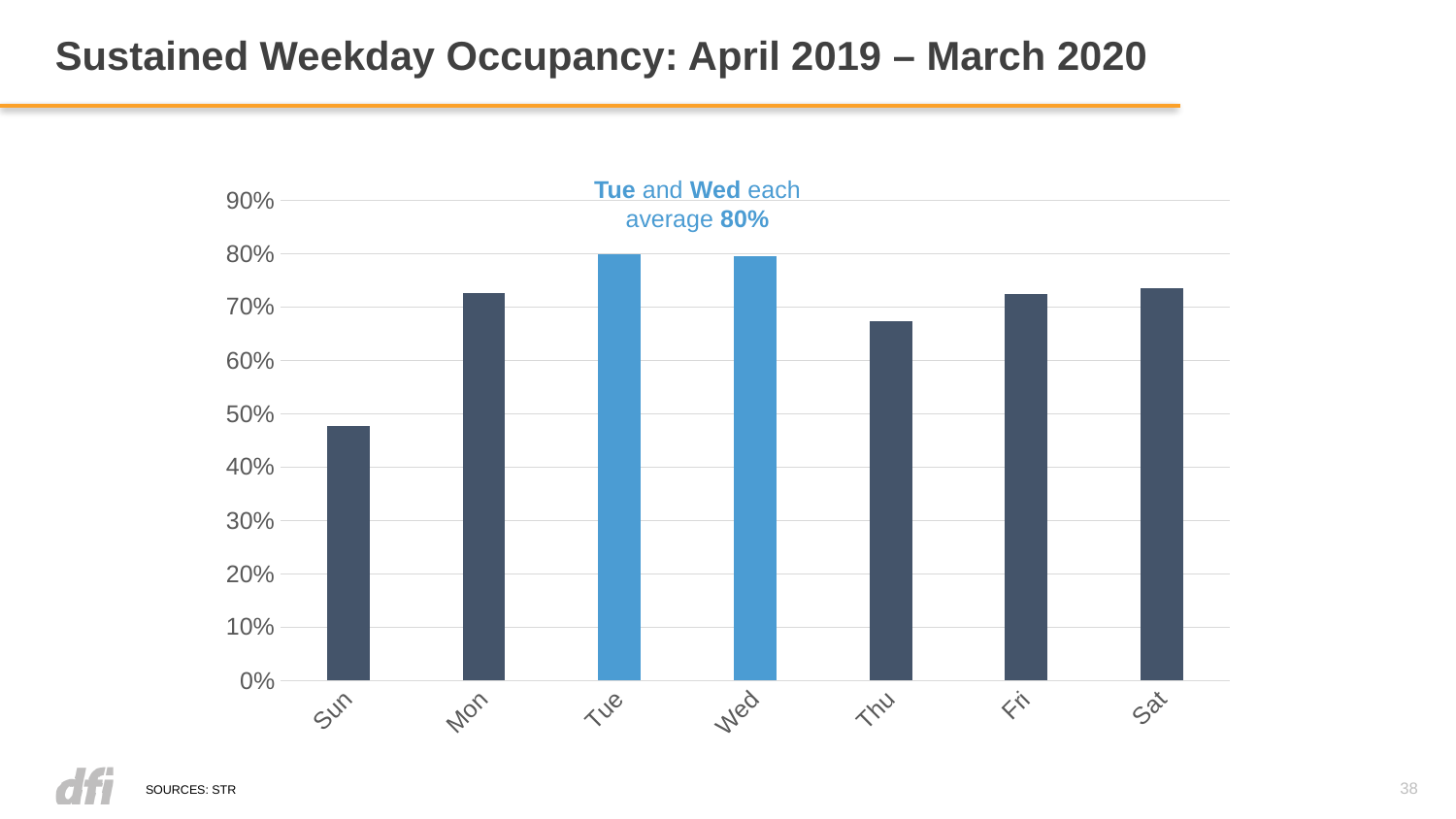
How many days of the week are plotted on the chart? 7 Is the value for Mon greater or less than 70%? greater According to the annotation on the chart, what is the average occupancy for Wed? 80% Which two days are highlighted in a lighter blue colour on the chart? Tue and Wed According to the annotation on the chart, what is the average occupancy for Tue? 80% Which has the higher occupancy, Sun or Mon? Mon Is the value for Thu greater or less than 70%? less Which has the higher occupancy, Thu or Tue? Tue What kind of chart is shown on the slide? bar chart Is the value for Sun greater or less than 50%? less Which day has the lowest occupancy on the chart? Sun